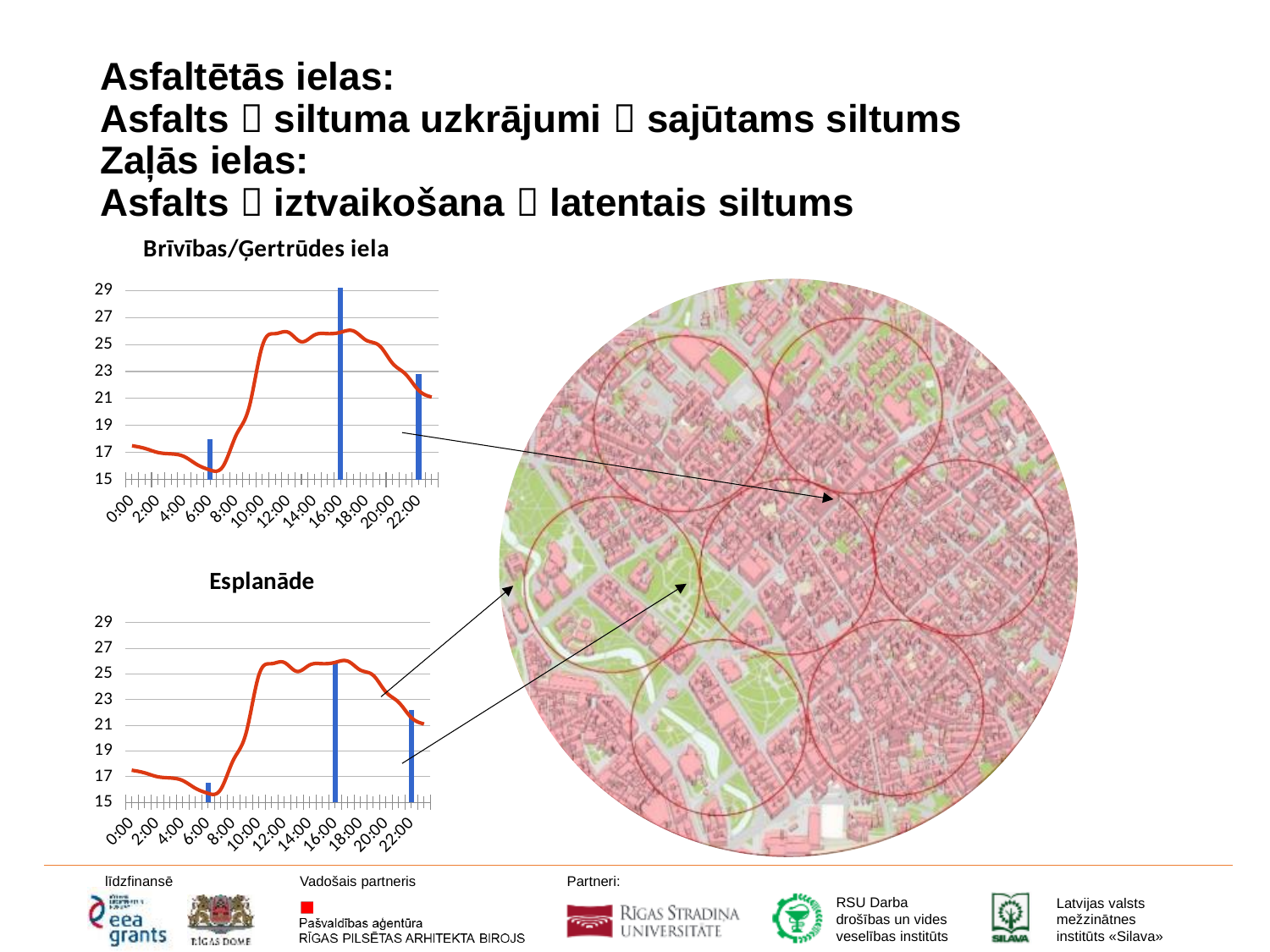
In the Brīvības/Ģertrūdes iela chart, is the blue bar at 16:00 greater or less than 27? greater In the Esplanāde chart, how many time labels are shown on the x axis? 12 Which chart has the taller blue bar at 16:00, Brīvības/Ģertrūdes iela or Esplanāde? Brīvības/Ģertrūdes iela What is the title of the upper chart on the slide? Brīvības/Ģertrūdes iela What is the title of the lower chart on the slide? Esplanāde In the Esplanāde chart, is the blue bar at 6:00 greater or less than 17? less In the Brīvības/Ģertrūdes iela chart, which blue bar is taller, the one at 16:00 or the one at 22:00? 16:00 In the Esplanāde chart, is the blue bar at 22:00 greater or less than 21? greater In the Esplanāde chart, at which time is the shortest blue bar? 6:00 In the Brīvības/Ģertrūdes iela chart, how many blue bars are plotted? 3 In the Brīvības/Ģertrūdes iela chart, at which time is the tallest blue bar? 16:00 In the Esplanāde chart, does the red line rise or fall between 6:00 and 12:00? rise